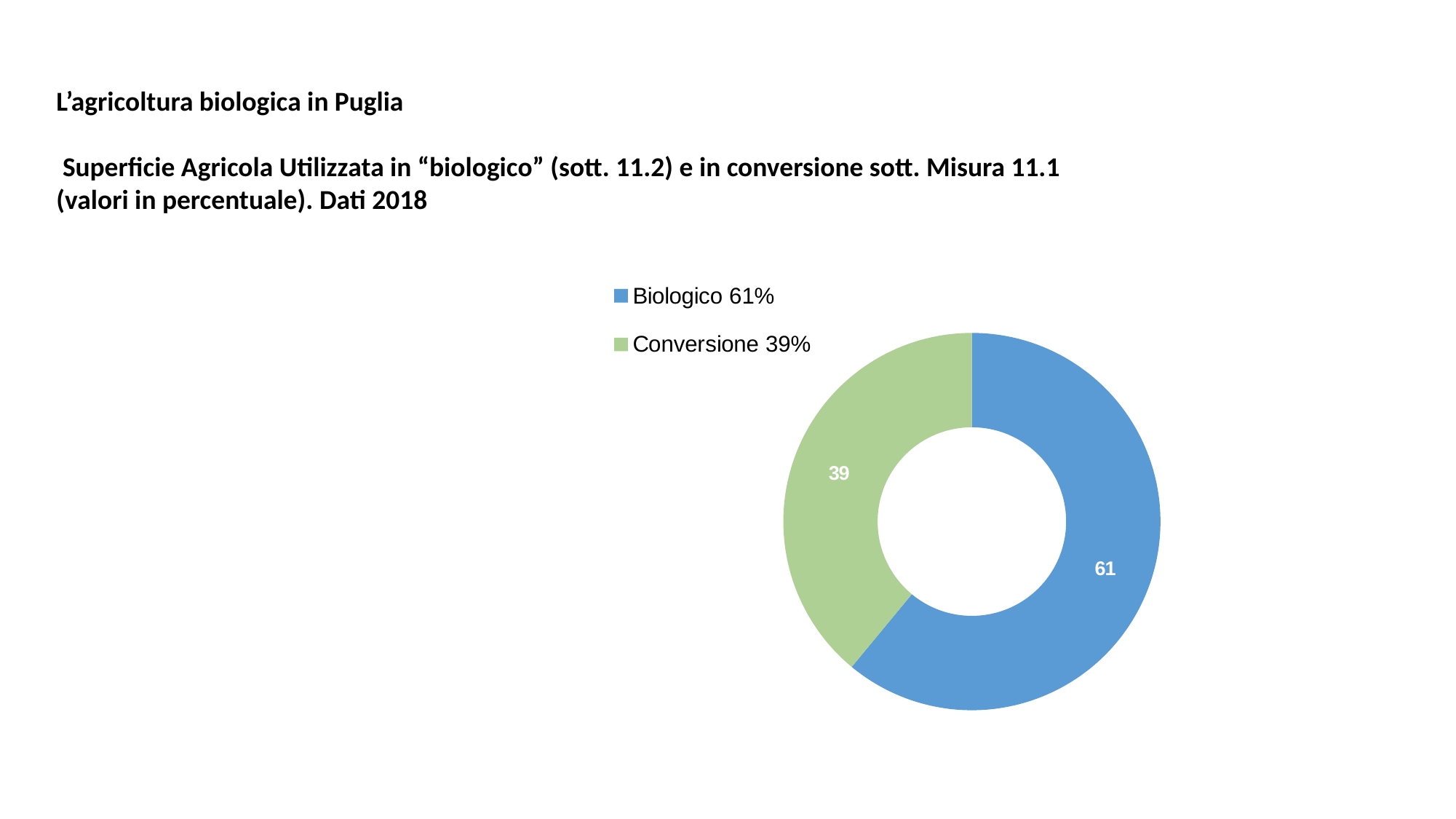
What kind of chart is shown on the slide? Doughnut (pie) chart What share of the chart does Conversione represent according to the legend? 39% What is the difference between the values for Biologico and Conversione? 22 What is the value shown for Conversione? 39 Which category has the largest share of the chart? Biologico How many categories does the chart show? 2 What year do the data on the slide refer to? 2018 What share of the chart does Biologico represent according to the legend? 61% What is the value shown for Biologico? 61 Which is larger, Biologico or Conversione? Biologico What colour is the Conversione segment? Green Which category has the smallest share of the chart? Conversione